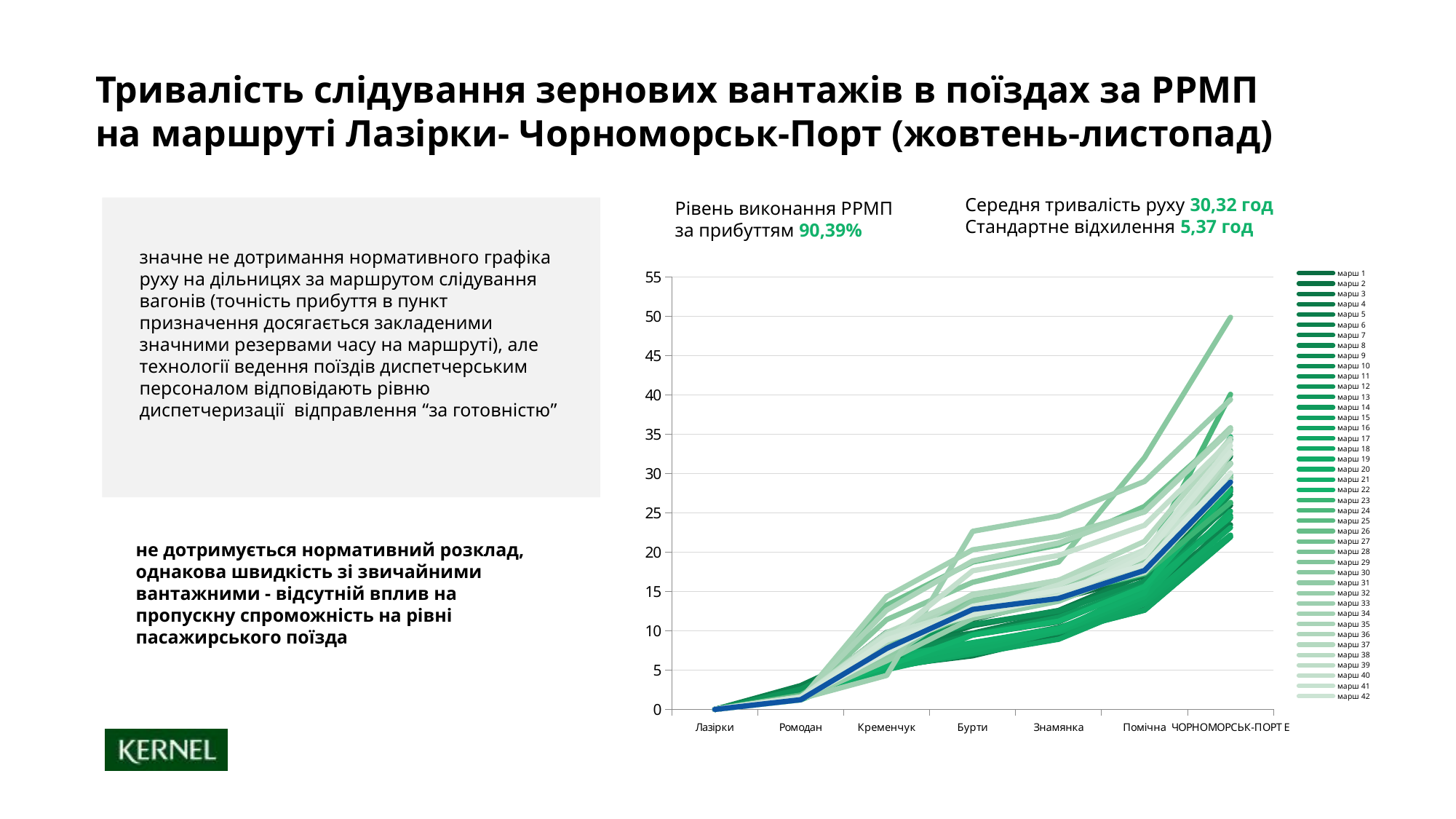
At which station do the lines reach their highest values? ЧОРНОМОРСЬК-ПОРТ Е How many stations are labelled along the x axis of the chart? 7 Is the highest value reached at ЧОРНОМОРСЬК-ПОРТ Е greater or less than 45? greater What kind of chart is shown on the slide? line chart Are the values at Ромодан greater or less than 5? less How many series does the chart legend list? 42 What is the highest tick value shown on the y axis of the chart? 55 At which station do the lines have their lowest values? Лазірки Is the highest value at Бурти greater or less than 20? greater What is the first station labelled on the x axis of the chart? Лазірки Do the lines in the chart rise or fall from Лазірки to ЧОРНОМОРСЬК-ПОРТ Е? rise